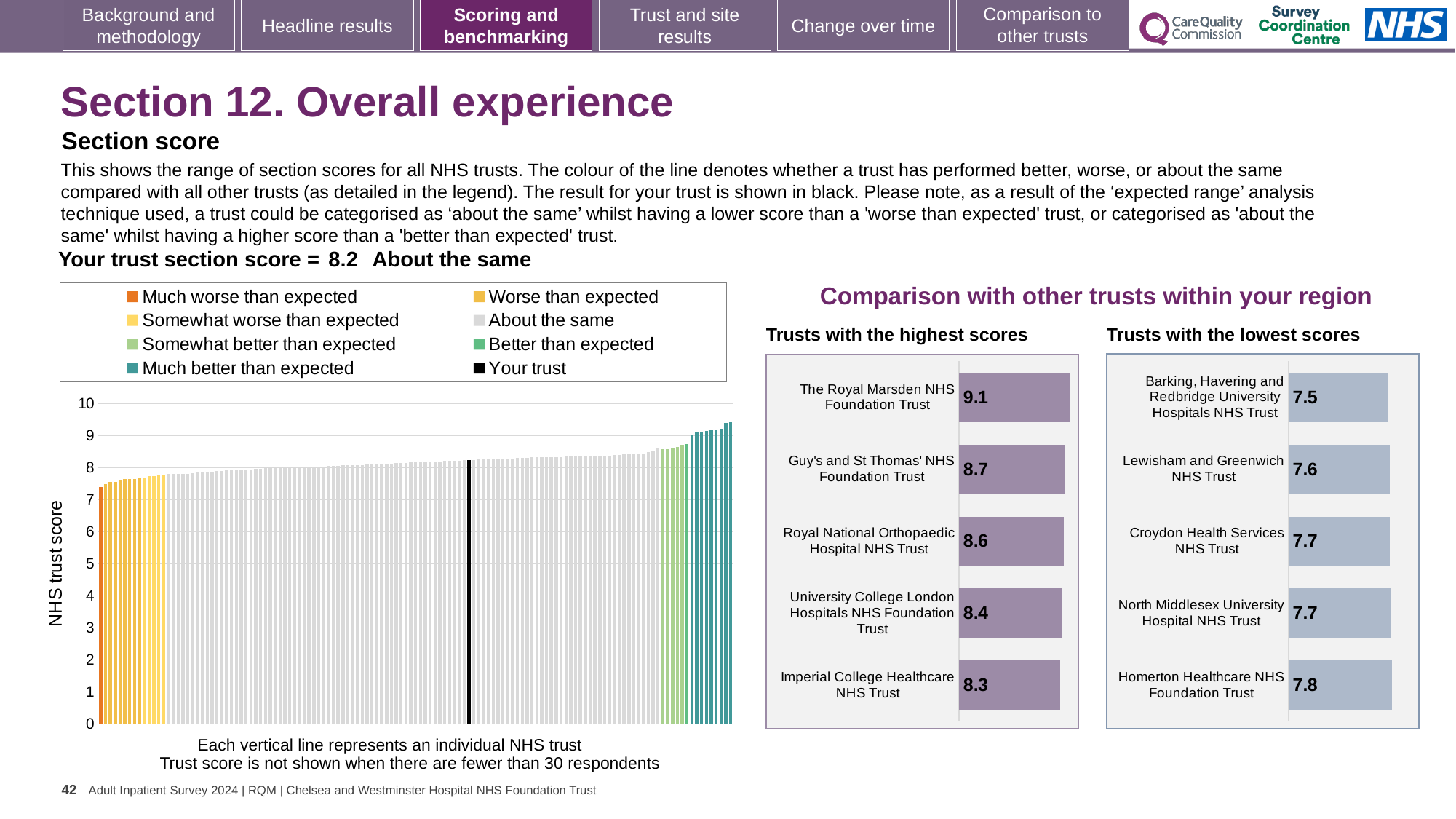
In the 'Trusts with the lowest scores' chart, which trust has the lowest score? Barking, Havering and Redbridge University Hospitals NHS Trust In the 'Trusts with the highest scores' chart, what is the score for Imperial College Healthcare NHS Trust? 8.3 In the 'Trusts with the lowest scores' chart, what is the difference between the scores of Homerton Healthcare NHS Foundation Trust and Barking, Havering and Redbridge University Hospitals NHS Trust? 0.3 How many trusts are shown in the 'Trusts with the lowest scores' chart? 5 In the 'Trusts with the highest scores' chart, which has the higher score: Royal National Orthopaedic Hospital NHS Trust or University College London Hospitals NHS Foundation Trust? Royal National Orthopaedic Hospital NHS Trust What kind of chart is the main section score chart on the left of the slide? Bar chart In the 'Trusts with the highest scores' chart, what is the score for The Royal Marsden NHS Foundation Trust? 9.1 How many entries does the legend of the main section score chart list? 8 In the main section score chart, do the trust scores rise or fall from left to right along the x axis? Rise In the 'Trusts with the lowest scores' chart, what is the score for Lewisham and Greenwich NHS Trust? 7.6 In the 'Trusts with the highest scores' chart, which trust has the highest score? The Royal Marsden NHS Foundation Trust In the 'Trusts with the highest scores' chart, what is the difference between the scores of The Royal Marsden NHS Foundation Trust and Guy's and St Thomas' NHS Foundation Trust? 0.4